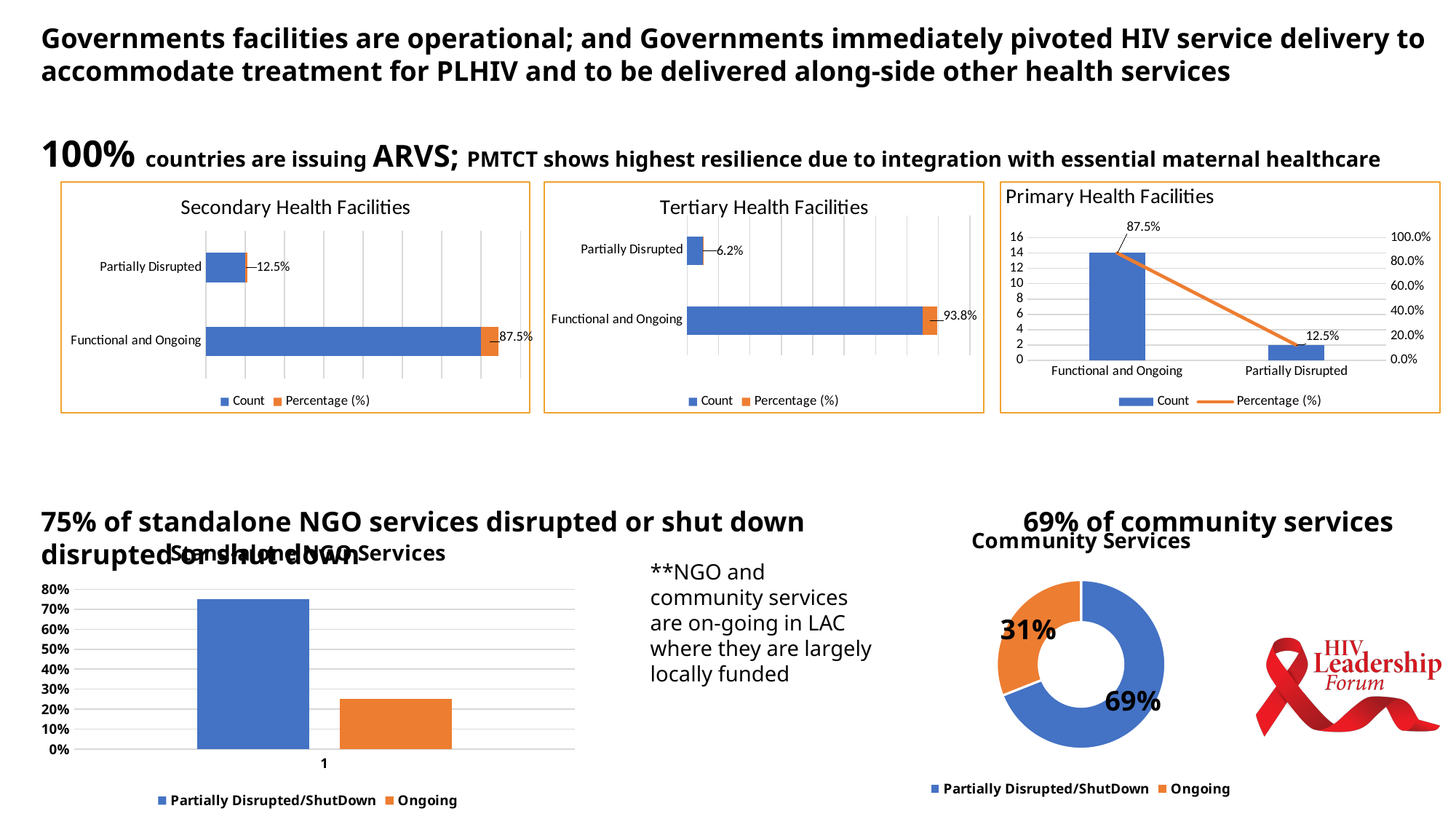
In the Tertiary Health Facilities chart, what percentage is shown for Functional and Ongoing? 93.8% In the Standalone NGO Services chart, is the value for Partially Disrupted/ShutDown greater or less than 50%? greater In the Standalone NGO Services chart, is the value for Ongoing greater or less than 30%? less In the Tertiary Health Facilities chart, what is the difference in percentage between Functional and Ongoing and Partially Disrupted? 87.6% In the Primary Health Facilities chart, what percentage is shown for Partially Disrupted? 12.5% What kind of chart is the Community Services chart? doughnut chart In the Community Services chart, which slice is larger, Partially Disrupted/ShutDown or Ongoing? Partially Disrupted/ShutDown How many categories are shown in the Secondary Health Facilities chart? 2 In the Community Services chart, what share of the pie is Ongoing? 31% How many series does the legend of the Primary Health Facilities chart list? 2 In the Primary Health Facilities chart, what is the count for Functional and Ongoing? 14 In the Secondary Health Facilities chart, what percentage is shown for Partially Disrupted? 12.5%